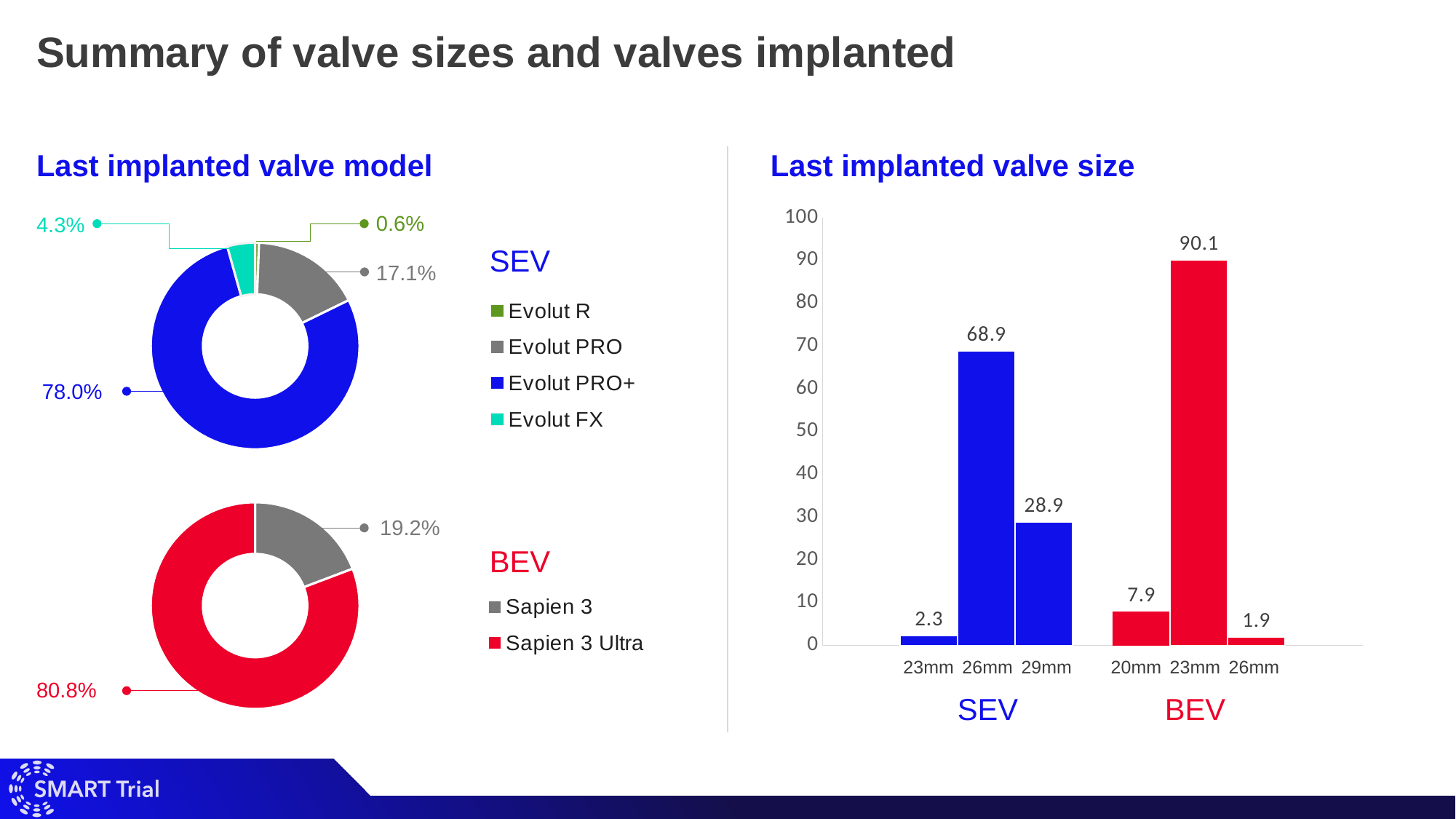
In the 'Last implanted valve size' chart, what is the difference between SEV 26mm and SEV 29mm? 40.0 In the 'Last implanted valve model' SEV donut chart, which valve model has the smallest share? Evolut R In the 'Last implanted valve model' BEV donut chart, what is the difference between the Sapien 3 Ultra and Sapien 3 shares? 61.6% In the 'Last implanted valve size' chart, which is larger: SEV 23mm or BEV 26mm? SEV 23mm What kind of chart is the 'Last implanted valve size' chart? Bar chart In the 'Last implanted valve size' chart, which valve size has the highest value? BEV 23mm In the 'Last implanted valve model' BEV donut chart, what share does Sapien 3 Ultra have? 80.8% In the 'Last implanted valve model' SEV donut chart, what share does Evolut PRO+ have? 78.0% In the 'Last implanted valve model' SEV donut chart, what share does Evolut PRO have? 17.1% How many entries does the SEV legend list in the 'Last implanted valve model' chart? 4 In the 'Last implanted valve size' chart, what is the value for BEV 20mm? 7.9 In the 'Last implanted valve size' chart, what is the value for SEV 26mm? 68.9